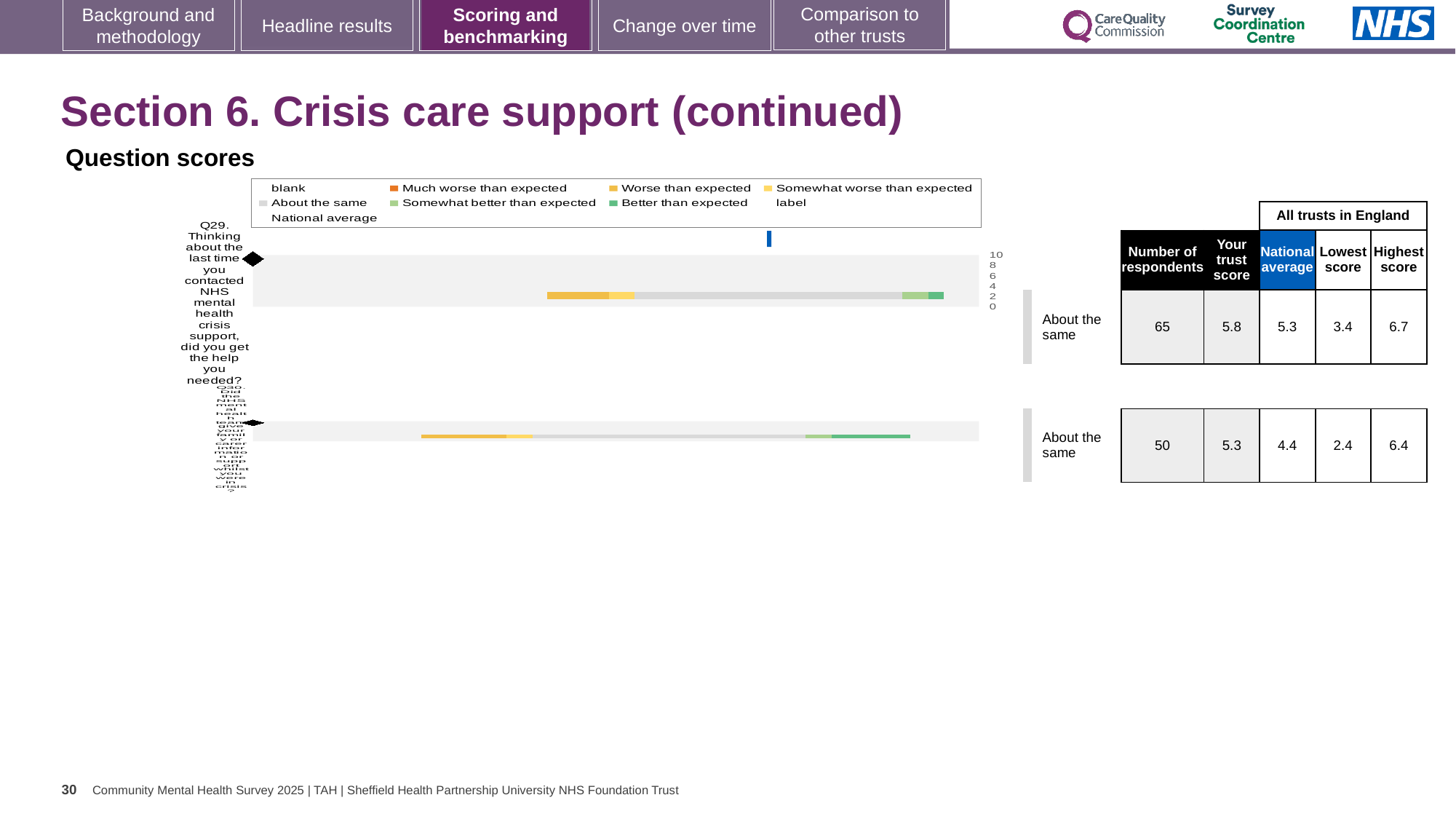
What is the lowest score among all trusts in England for Q30? 2.4 What is the maximum value shown on the score axis of the chart? 10 What kind of chart is used to show the question scores for Q29 and Q30? Bar chart What is the national average for Q29 shown next to the chart? 5.3 What is the trust score for Q29 shown next to the chart? 5.8 What is the difference between the trust score and the national average for Q30? 0.9 What is the number of respondents for Q30? 50 How many questions (categories) are plotted in the question scores chart? 2 What is the highest score among all trusts in England for Q29? 6.7 What benchmark category is given for Q29 in the chart? About the same Which question has the higher trust score, Q29 or Q30? Q29 How many entries does the legend of the question scores chart list? 9